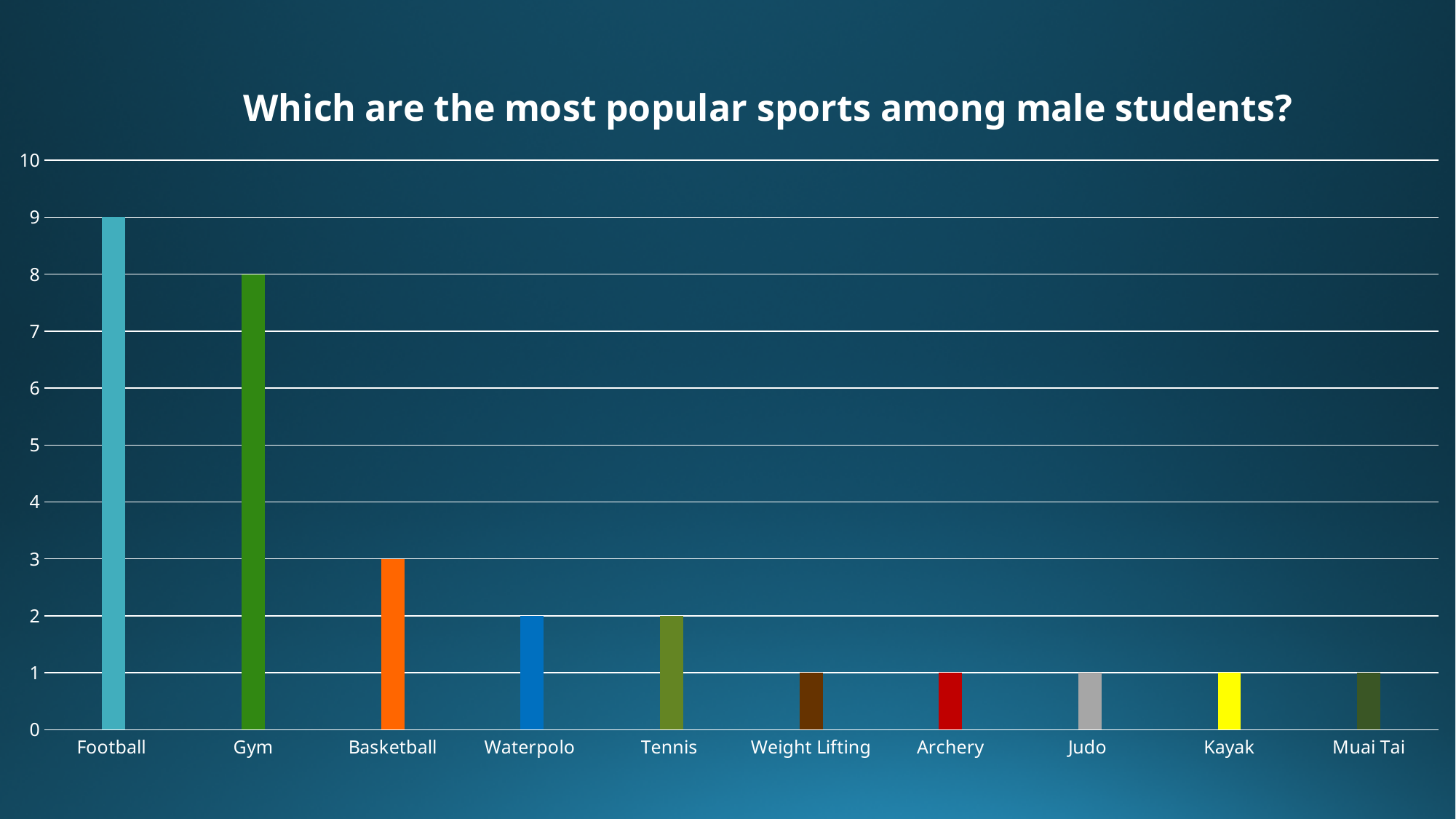
What is the title of the chart? Which are the most popular sports among male students? Which has a larger value, Basketball or Tennis? Basketball What kind of chart is shown on the slide? Bar chart What is the value for Gym? 8 What is the difference between the values for Football and Gym? 1 What is the value for Basketball? 3 Which sport has the highest value? Football What is the value for Football? 9 How many sports are shown on the x axis? 10 Is the value for Gym greater or less than 5? greater What is the difference between the values for Gym and Basketball? 5 What is the value for Waterpolo? 2